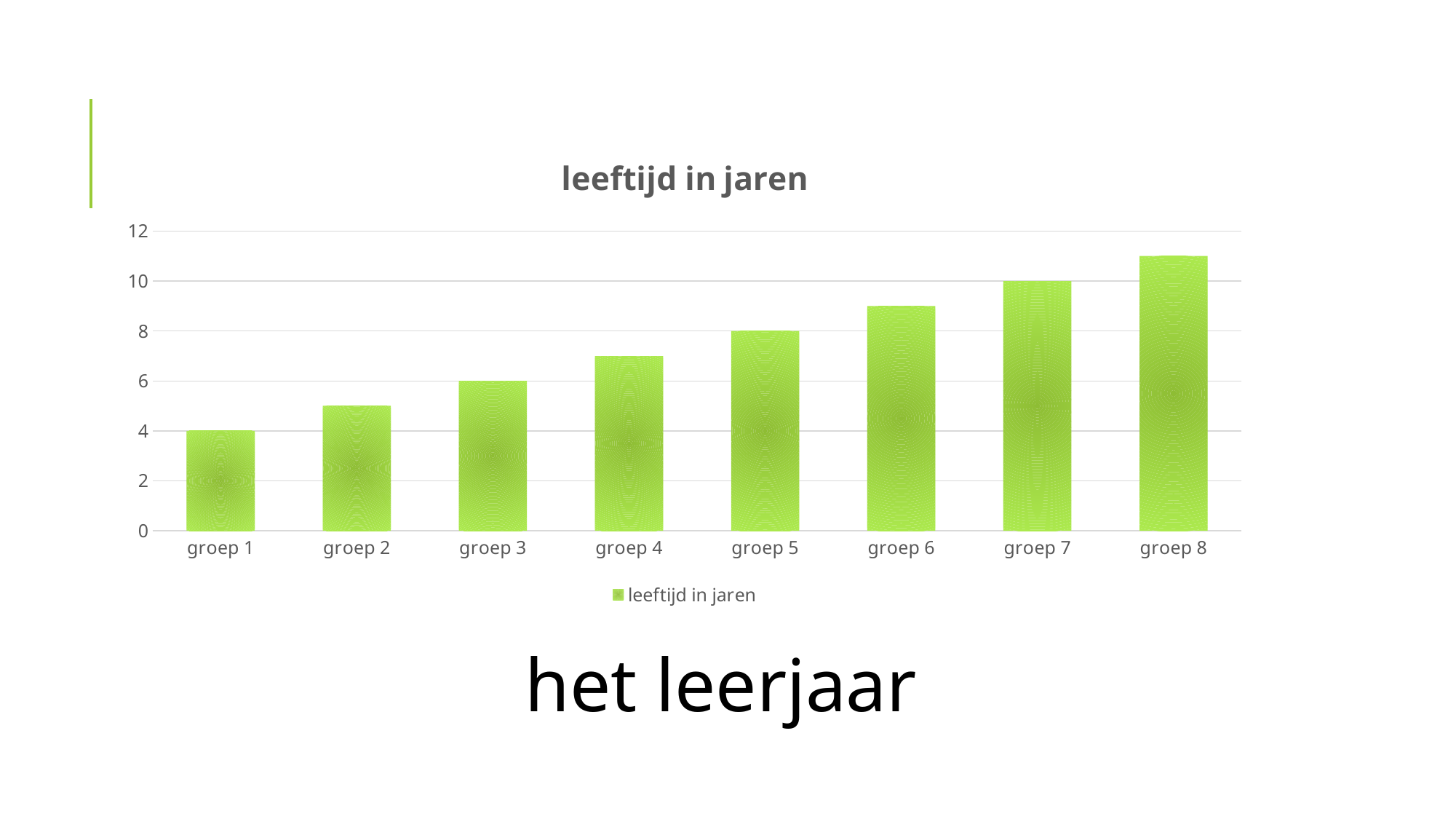
Which is larger, the value for groep 2 or the value for groep 6? groep 6 Which category has the highest value? groep 8 What is the value for groep 1? 4 How many categories are shown on the x axis? 8 What is the difference between the values for groep 7 and groep 1? 6 Do the values rise or fall from groep 1 to groep 8? rise What is the value for groep 5? 8 What is the value for groep 7? 10 Is the value for groep 8 greater or less than 10? greater Is the value for groep 4 greater or less than 6? greater What is the value for groep 3? 6 Which category has the lowest value? groep 1